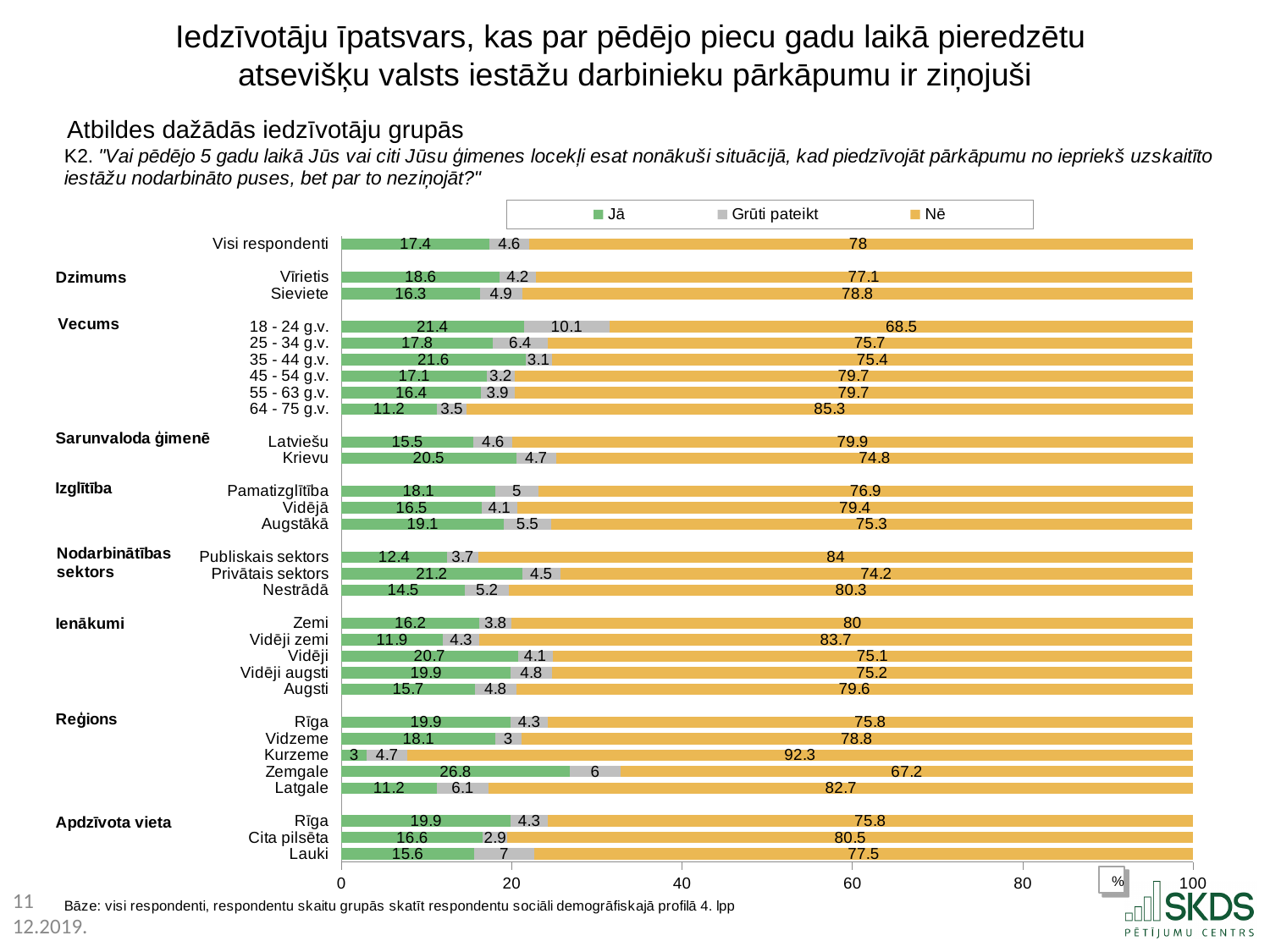
Among the regions (Reģions group), which has the highest "Jā" value? Zemgale What kind of chart is shown on the slide? Stacked bar chart Among the regions (Reģions group), which has the lowest "Jā" value? Kurzeme What is the value of the "Jā" series for "Visi respondenti"? 17.4 What is the difference between the "Nē" values for "Sieviete" and "Vīrietis"? 1.7 Among the age groups (Vecums), which has the highest "Nē" value? 64 - 75 g.v. What is the difference between the "Jā" values for "18 - 24 g.v." and "64 - 75 g.v."? 10.2 Which has a larger "Jā" value: "Publiskais sektors" or "Privātais sektors"? Privātais sektors How many series does the legend list? 3 What is the total of the stacked bar for "Zemgale"? 100 What is the value of the "Nē" series for "Kurzeme"? 92.3 What is the value of the "Grūti pateikt" series for "18 - 24 g.v."? 10.1